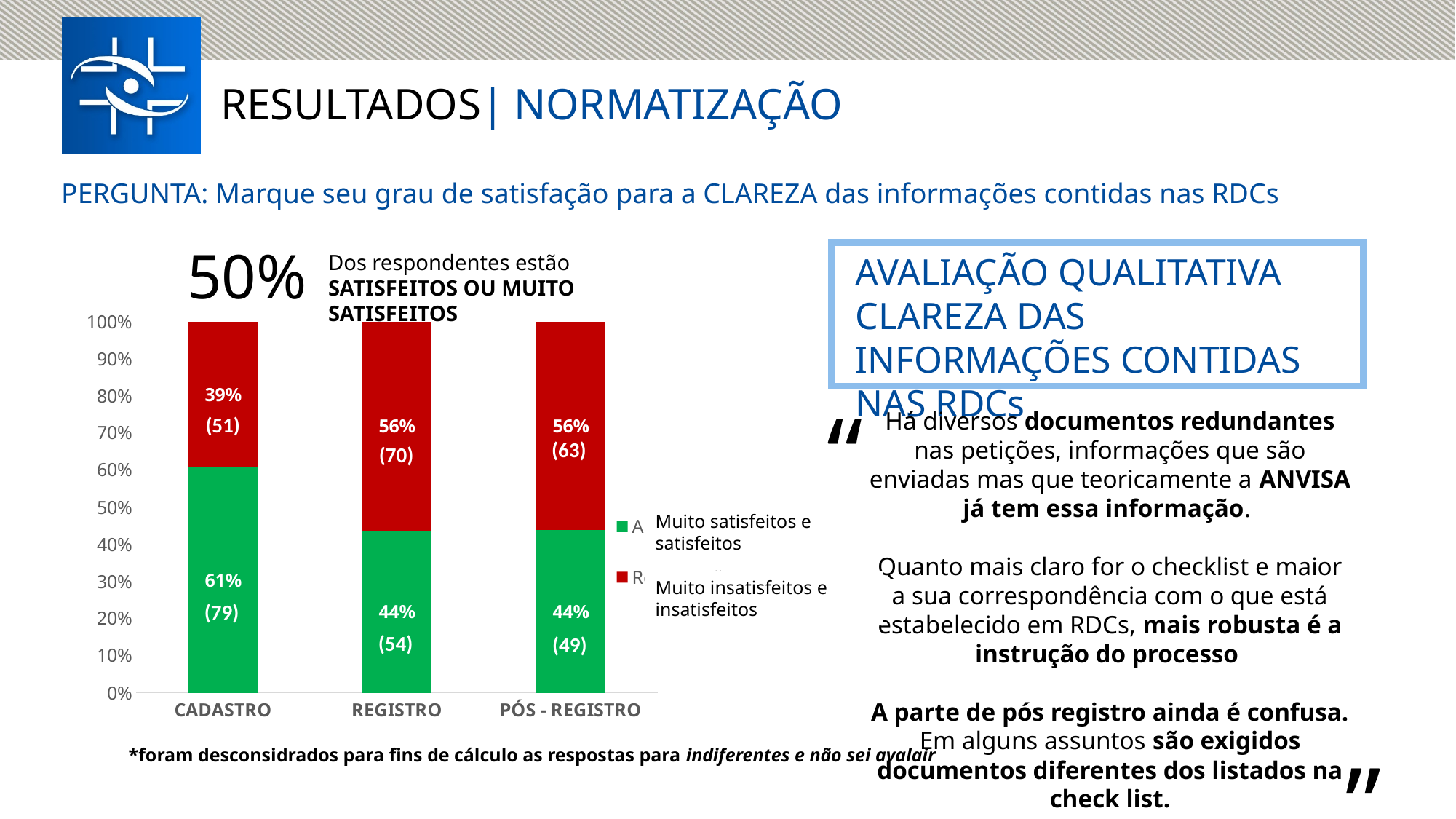
How many categories are shown on the x axis of the chart? 3 What kind of chart is shown on the slide? Stacked bar chart What is the difference in percentage points between the green segment for CADASTRO and the green segment for REGISTRO? 17 Which is larger: the red segment for REGISTRO or the red segment for CADASTRO? REGISTRO Which category has the lowest percentage of dissatisfied respondents (red segment)? CADASTRO What is the total of the stacked bar for PÓS - REGISTRO? 100% What large percentage figure is highlighted above the chart? 50% Which category has the highest percentage of satisfied respondents (green segment)? CADASTRO How many respondents are in the green (satisfied) segment for PÓS - REGISTRO? 49 What is the percentage of dissatisfied respondents (red segment) for REGISTRO? 56% How many respondents are in the red (dissatisfied) segment for CADASTRO? 51 What is the percentage of satisfied respondents (green segment) for CADASTRO? 61%